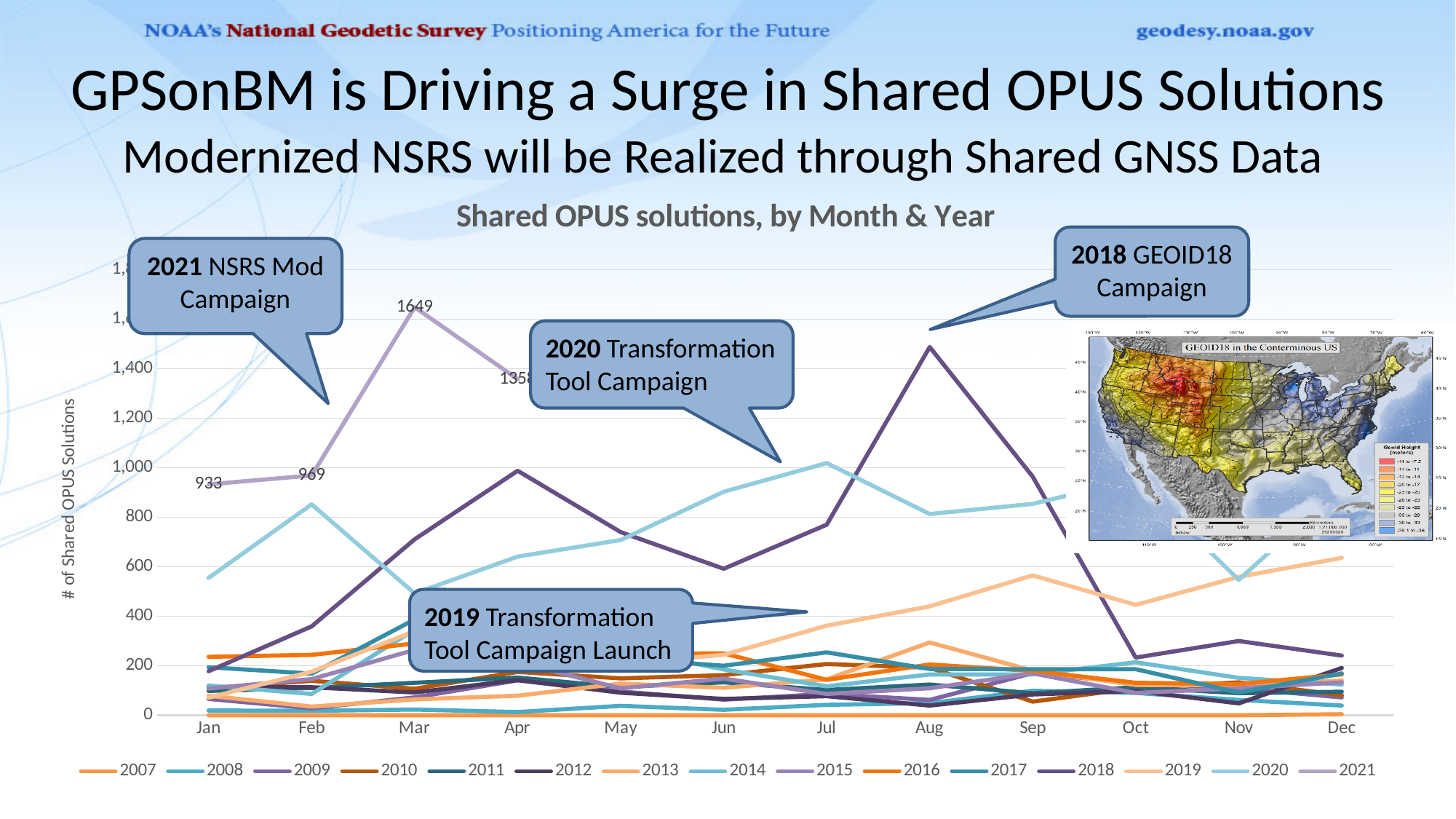
What is the number of shared OPUS solutions for 2021 in February? 969 What is the number of shared OPUS solutions for 2021 in March? 1649 Which month has the highest value for the 2021 series? Mar What is the label on the y axis of the chart? # of Shared OPUS Solutions What is the difference between the 2021 values for March and February? 680 Does the 2021 series rise or fall from January to March? rise What is the difference between the 2021 values for February and January? 36 What is the number of shared OPUS solutions for 2021 in January? 933 How many series does the chart legend list? 15 Is the value for 2018 in August greater or less than 1,400? greater What kind of chart is shown on the slide? line chart How many months are shown along the x axis of the chart? 12